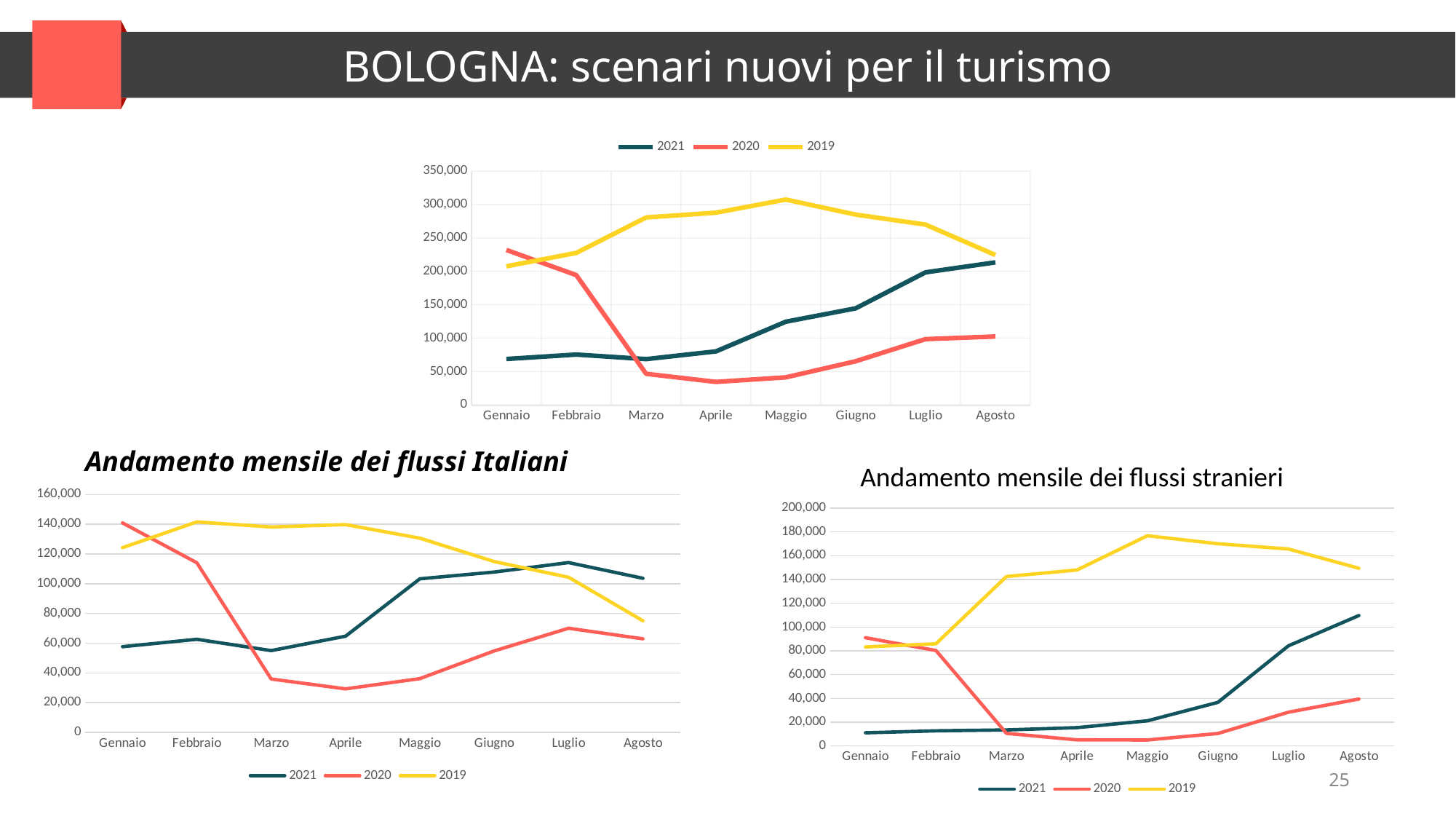
What type of chart is the top chart on the slide? line chart In the chart titled 'Andamento mensile dei flussi stranieri', in which month does the 2019 series reach its highest value? Maggio In the chart titled 'Andamento mensile dei flussi stranieri', which series has the larger value in Gennaio, 2020 or 2019? 2020 How many months are shown on the x axis of the chart titled 'Andamento mensile dei flussi Italiani'? 8 How many series does the legend of the top chart list? 3 In the top chart, does the 2021 series rise or fall from Marzo to Agosto? rise In the top chart, in which month does the 2020 series reach its lowest value? Aprile In the chart titled 'Andamento mensile dei flussi Italiani', is the 2019 value for Agosto greater or less than 80,000? less In the top chart, in which month does the 2019 series reach its highest value? Maggio In the chart titled 'Andamento mensile dei flussi stranieri', is the 2021 value for Agosto greater or less than 100,000? greater In the chart titled 'Andamento mensile dei flussi Italiani', in which month does the 2020 series reach its lowest value? Aprile In the top chart, is the 2021 value for Agosto greater or less than 200,000? greater